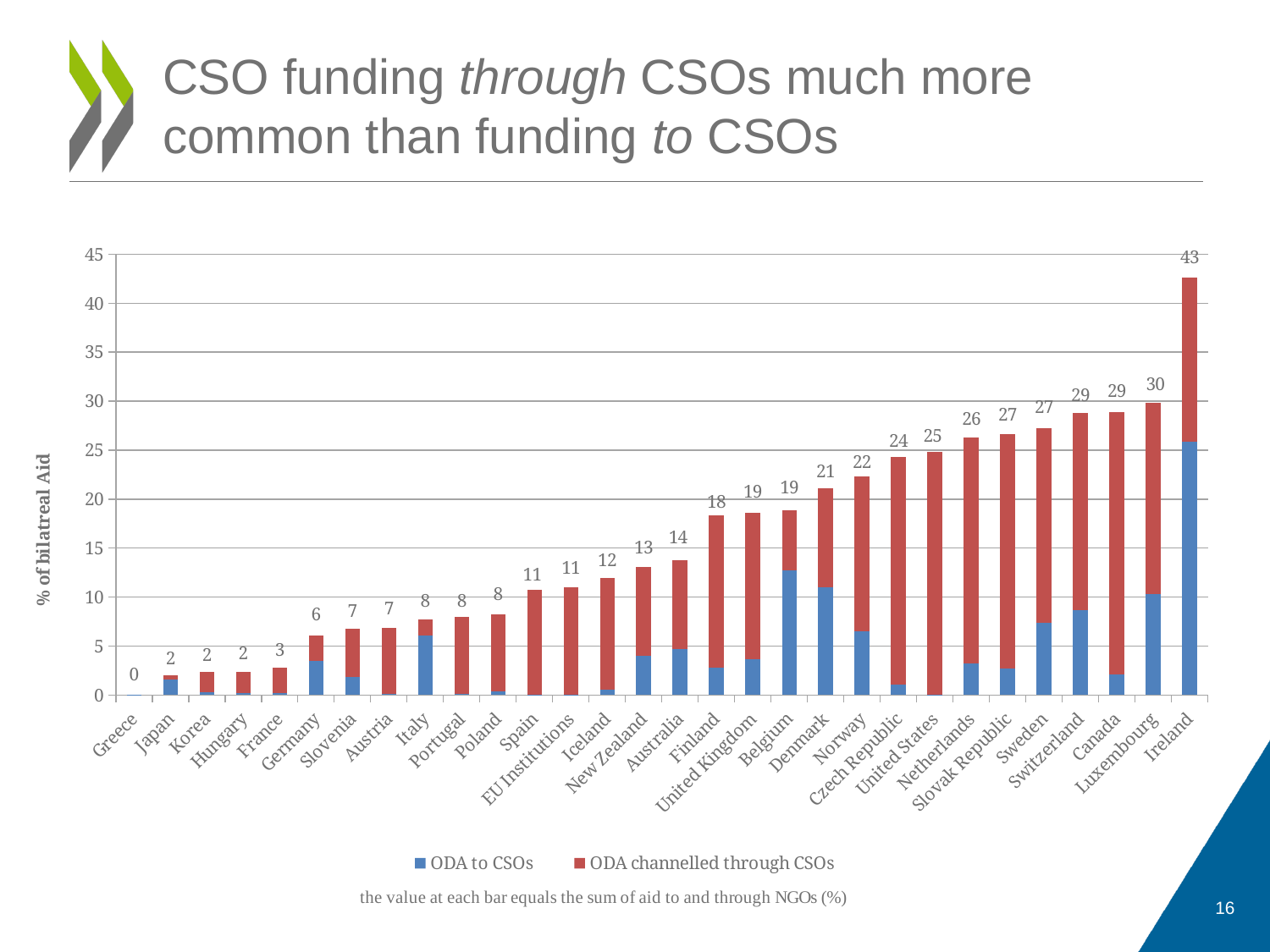
What kind of chart is shown on the slide? Stacked bar chart Which country has the lowest total value? Greece How many series does the legend list? 2 What is the total value shown for Finland? 18 What is the difference between the total values for Ireland and Luxembourg? 13 How many countries or institutions are shown on the x axis? 30 Is the ODA to CSOs value for Belgium greater or less than 10? greater Which country has the highest total value? Ireland Do the total values rise or fall moving from left to right along the x axis? Rise What is the title of the y axis? % of bilatreal Aid What is the total value shown for Ireland? 43 Which has a larger total value, Norway or Denmark? Norway